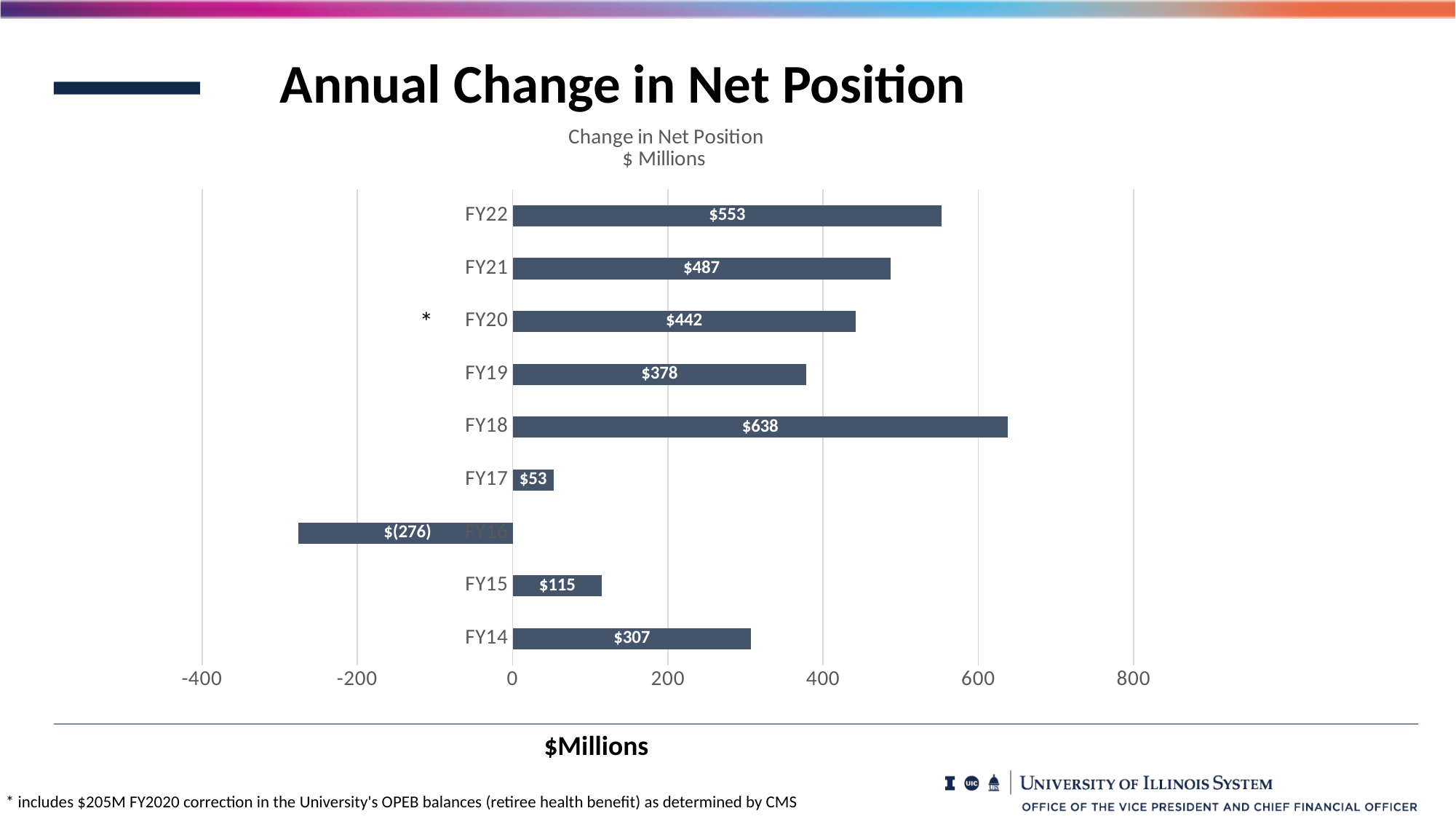
Which fiscal year has the lowest change in net position? FY16 What is the change in net position for FY16? $(276) What unit is shown on the chart's axis label? $Millions How many fiscal years are shown in the chart? 9 Is the value for FY20 greater or less than 400? greater What is the difference between the FY18 and FY19 values? $260 What is the change in net position for FY17? $53 What kind of chart is shown on the slide? bar chart Which is larger, the value for FY19 or the value for FY14? FY19 What is the change in net position for FY22? $553 What is the difference between the FY22 and FY21 values? $66 Which fiscal year has the highest change in net position? FY18